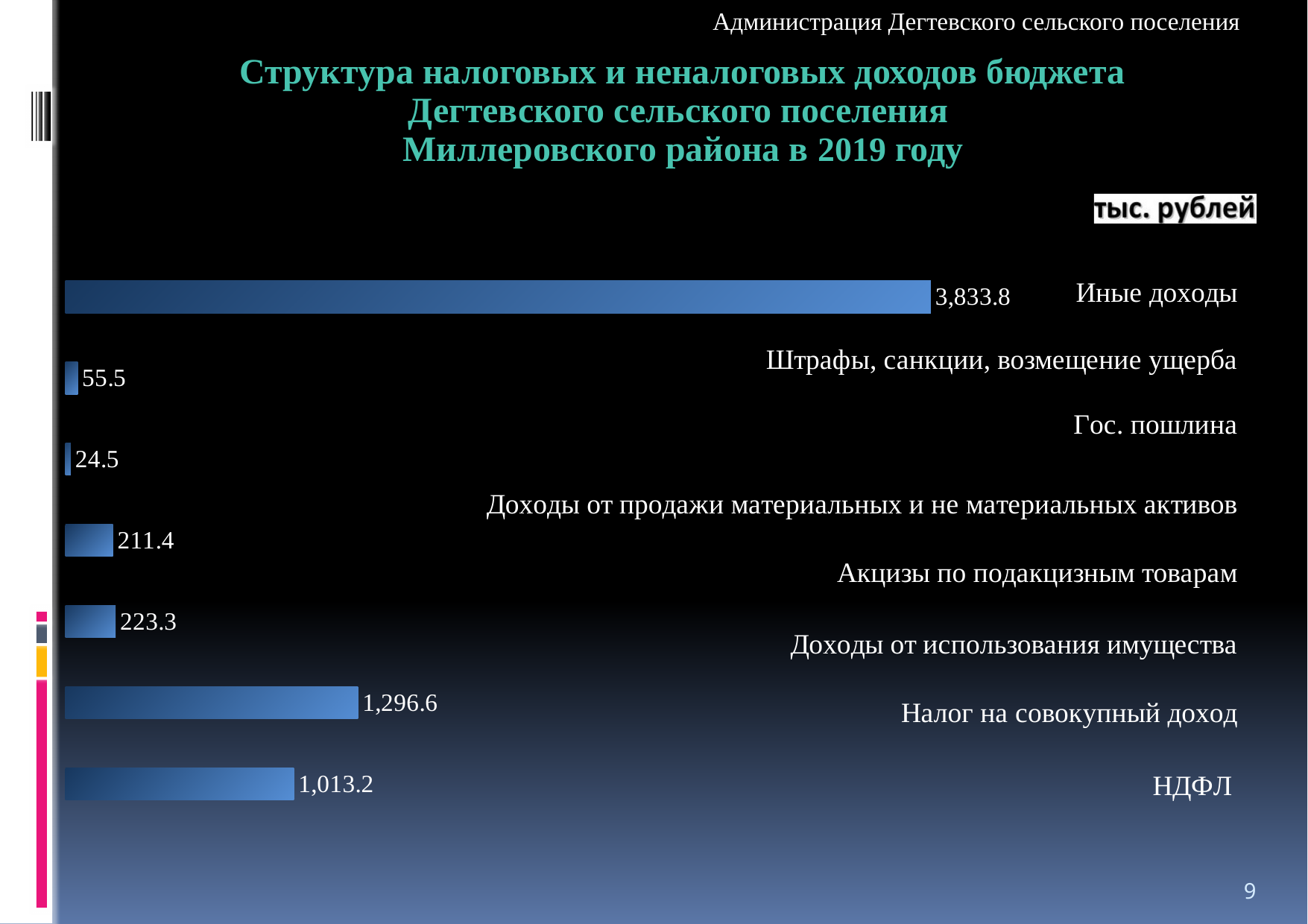
In what units are the chart values given? тыс. рублей What kind of chart is shown on the slide? bar chart What is the value of the bar for Иные доходы? 3,833.8 What is the smallest value shown in the chart? 24.5 What is the difference between the bar for Иные доходы (3,833.8) and the bar for НДФЛ (1,013.2)? 2,820.6 What is the largest value shown in the chart? 3,833.8 Which is larger: the bar for Иные доходы or the bar for НДФЛ? Иные доходы Which year does the chart title say the budget revenue structure refers to? 2019 What is the difference between the bar labelled 55.5 and the bar labelled 24.5? 31 What is the value of the bar for НДФЛ? 1,013.2 What is the difference between the bar labelled 1,296.6 and the bar labelled 1,013.2? 283.4 How many bars are plotted in the chart? 7